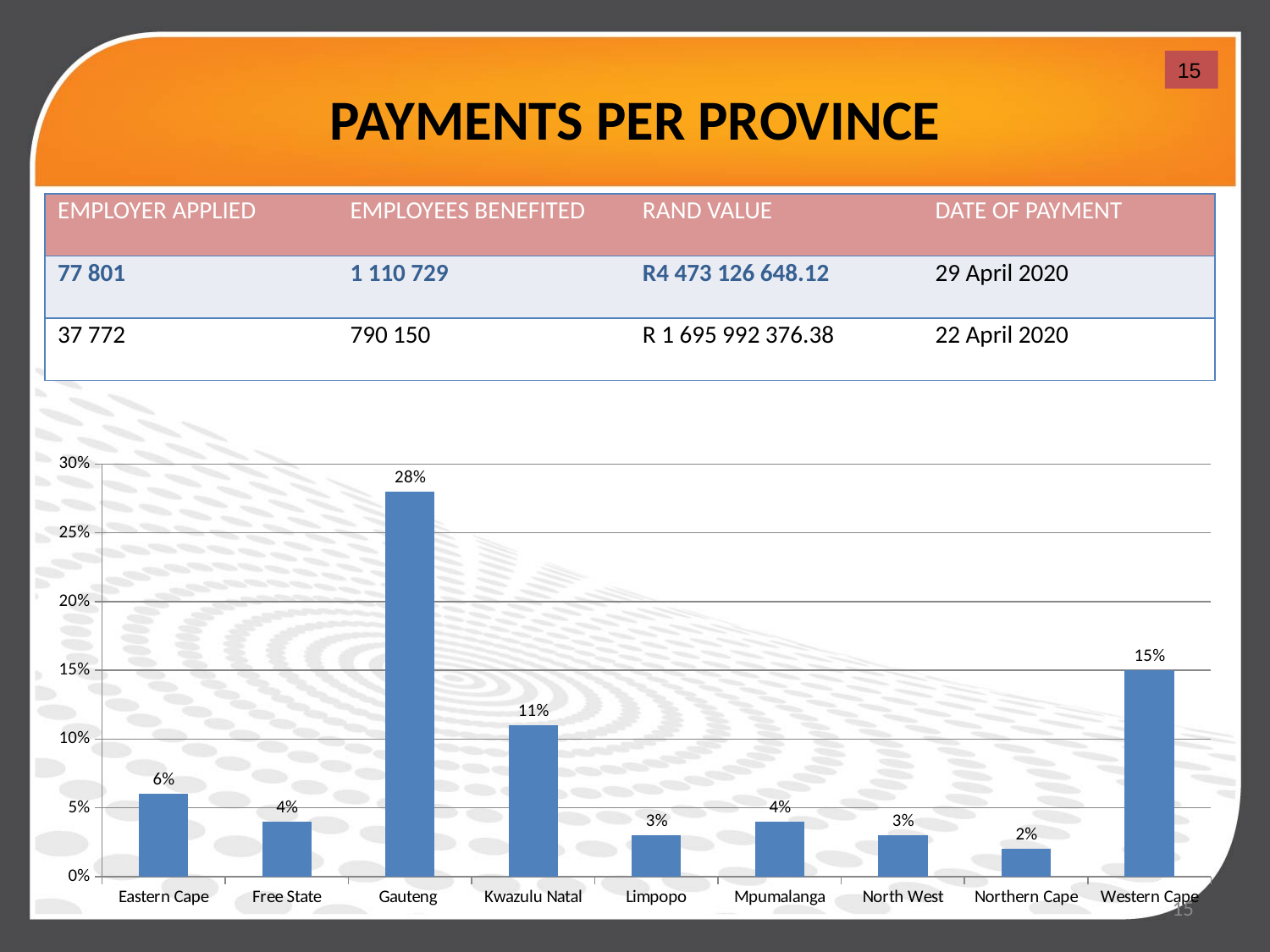
Is the value for Kwazulu Natal greater or less than 10%? greater Which province has the highest value? Gauteng What is the title of the slide containing the chart? PAYMENTS PER PROVINCE Which is larger, the value for Eastern Cape or the value for Free State? Eastern Cape What is the difference between the values for Gauteng and Western Cape? 13% What is the value for Gauteng? 28% How many provinces are shown on the chart? 9 What kind of chart is shown on the slide? bar chart What is the value for Kwazulu Natal? 11% What is the value for Western Cape? 15% What is the value for Northern Cape? 2% Which province has the lowest value? Northern Cape